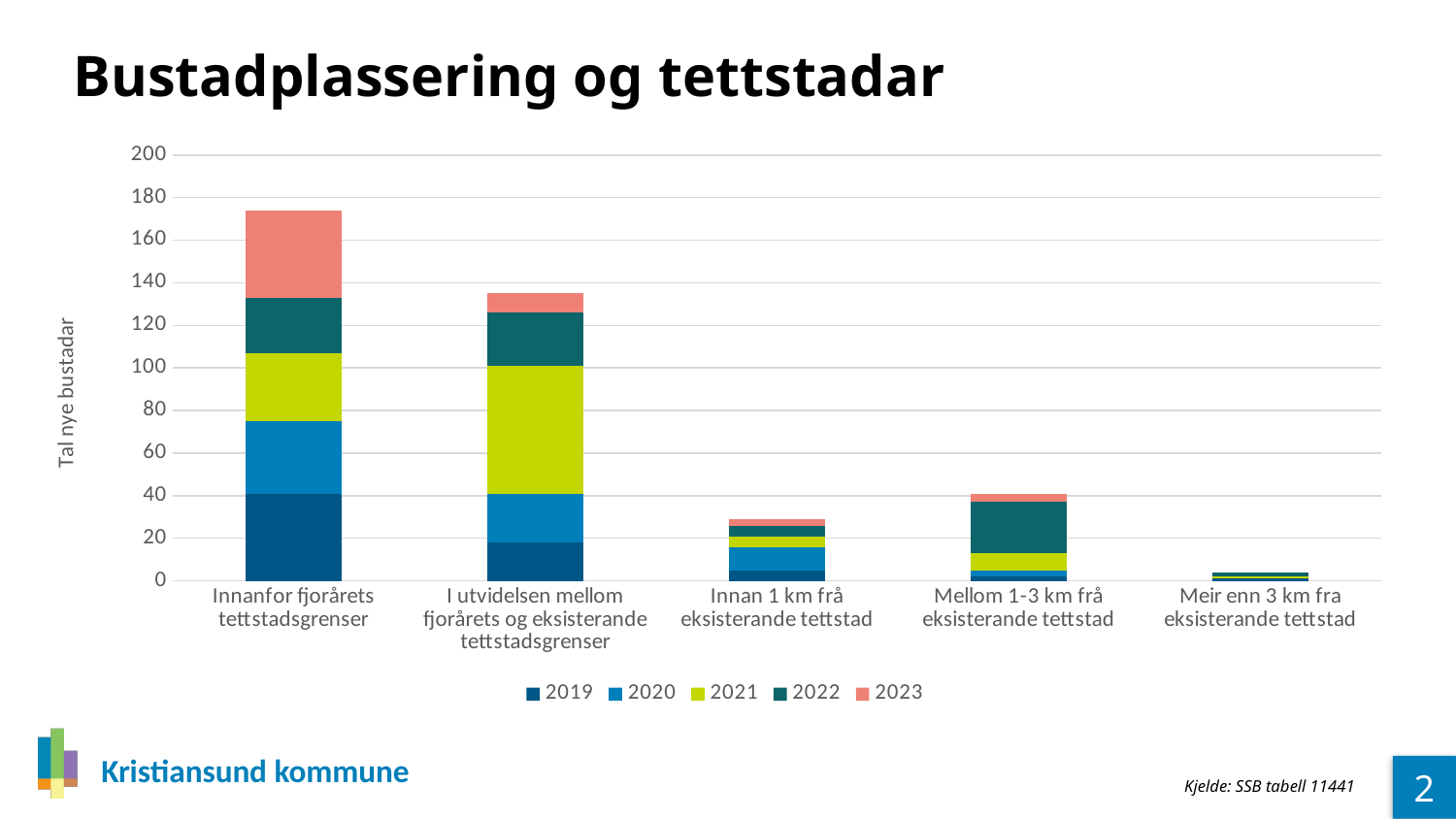
What kind of chart is shown on the slide? Stacked bar chart Is the total stacked value for 'Meir enn 3 km fra eksisterande tettstad' greater or less than 20? less Is the total stacked value for 'I utvidelsen mellom fjorårets og eksisterande tettstadsgrenser' greater or less than 120? greater How many categories are shown along the x axis of the chart? 5 Which category has the tallest stacked bar? Innanfor fjorårets tettstadsgrenser Is the total stacked value for 'Innanfor fjorårets tettstadsgrenser' greater or less than 160? greater Which years are listed in the chart legend? 2019, 2020, 2021, 2022, 2023 Which has the larger total stacked bar: 'Mellom 1-3 km frå eksisterande tettstad' or 'Innan 1 km frå eksisterande tettstad'? Mellom 1-3 km frå eksisterande tettstad What is the label on the y axis of the chart? Tal nye bustadar How many series does the chart legend list? 5 Which category has the shortest stacked bar? Meir enn 3 km fra eksisterande tettstad